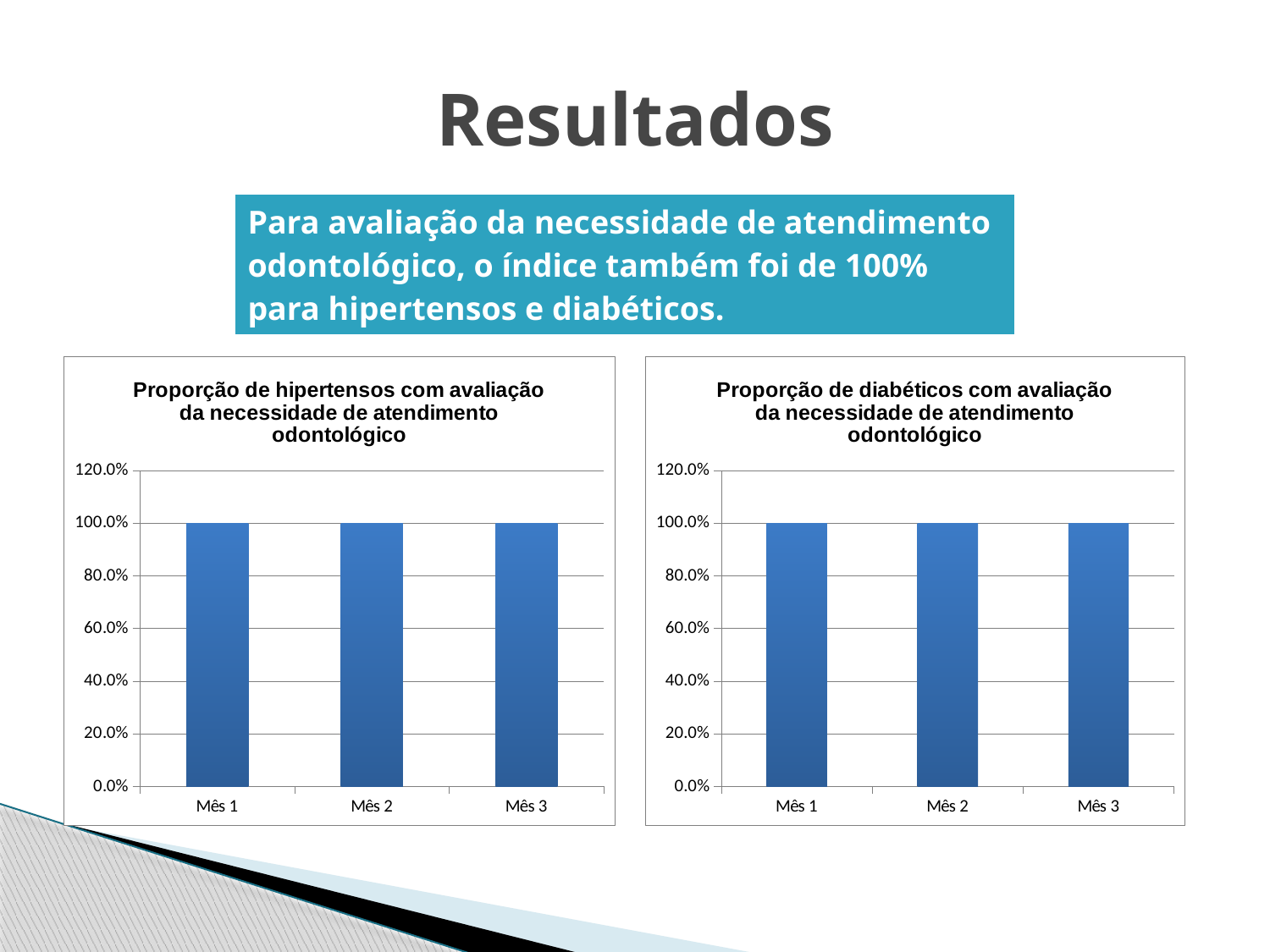
What kind of chart is the left chart (Proporção de hipertensos)? Bar chart In the left chart (Proporção de hipertensos com avaliação da necessidade de atendimento odontológico), what is the value for Mês 1? 100.0% In the right chart (Proporção de diabéticos), what is the value for Mês 2? 100.0% How many categories are shown on the x axis of the left chart (Proporção de hipertensos)? 3 In the left chart (Proporção de hipertensos), what is the difference between the values for Mês 1 and Mês 3? 0.0% Do the values in the right chart (Proporção de diabéticos) rise, fall, or stay the same from Mês 1 to Mês 3? Stay the same What kind of chart is the right chart (Proporção de diabéticos)? Bar chart In the left chart (Proporção de hipertensos), is the value for Mês 3 greater or less than 80.0%? greater How many bars are plotted in the right chart (Proporção de diabéticos)? 3 In the right chart (Proporção de diabéticos), is the value for Mês 1 greater or less than 120.0%? less In the left chart (Proporção de hipertensos), what is the value for Mês 2? 100.0% In the right chart (Proporção de diabéticos com avaliação da necessidade de atendimento odontológico), what is the value for Mês 3? 100.0%